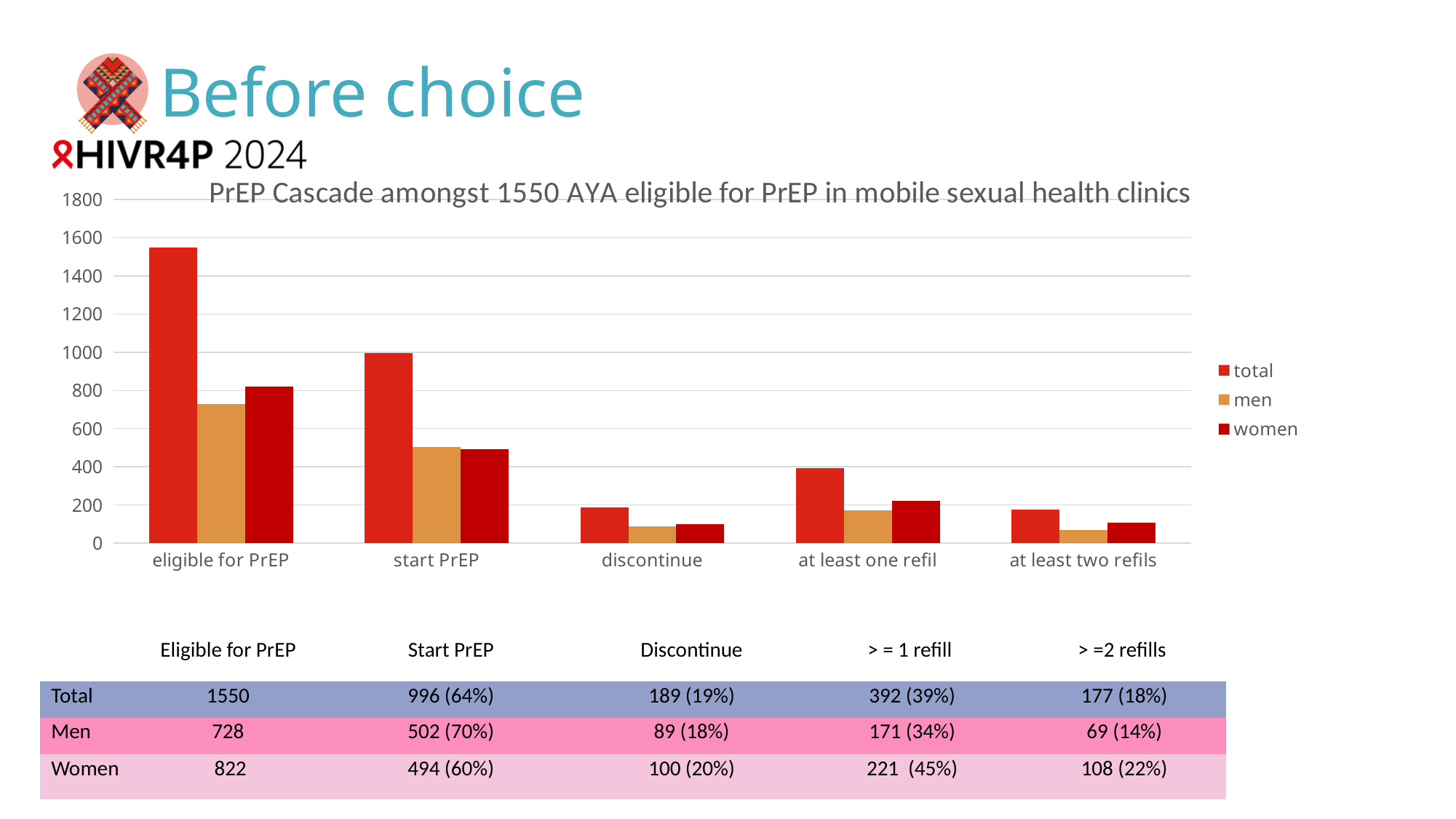
At 'at least one refil', which is larger, the value for men or the value for women? women Which category has the highest value for the total series? eligible for PrEP How many categories are shown along the x axis of the chart? 5 What kind of chart is shown on the slide? bar chart According to the table below the chart, what is the total value for Start PrEP? 996 (64%) At 'eligible for PrEP', which is larger, the value for men or the value for women? women According to the table below the chart, how many women were eligible for PrEP? 822 How many series does the chart legend list? 3 What is the chart's title? PrEP Cascade amongst 1550 AYA eligible for PrEP in mobile sexual health clinics Is the total value for 'start PrEP' greater or less than 800? greater Do the total values rise or fall from 'eligible for PrEP' to 'discontinue'? fall Is the value for men at 'discontinue' greater or less than 200? less